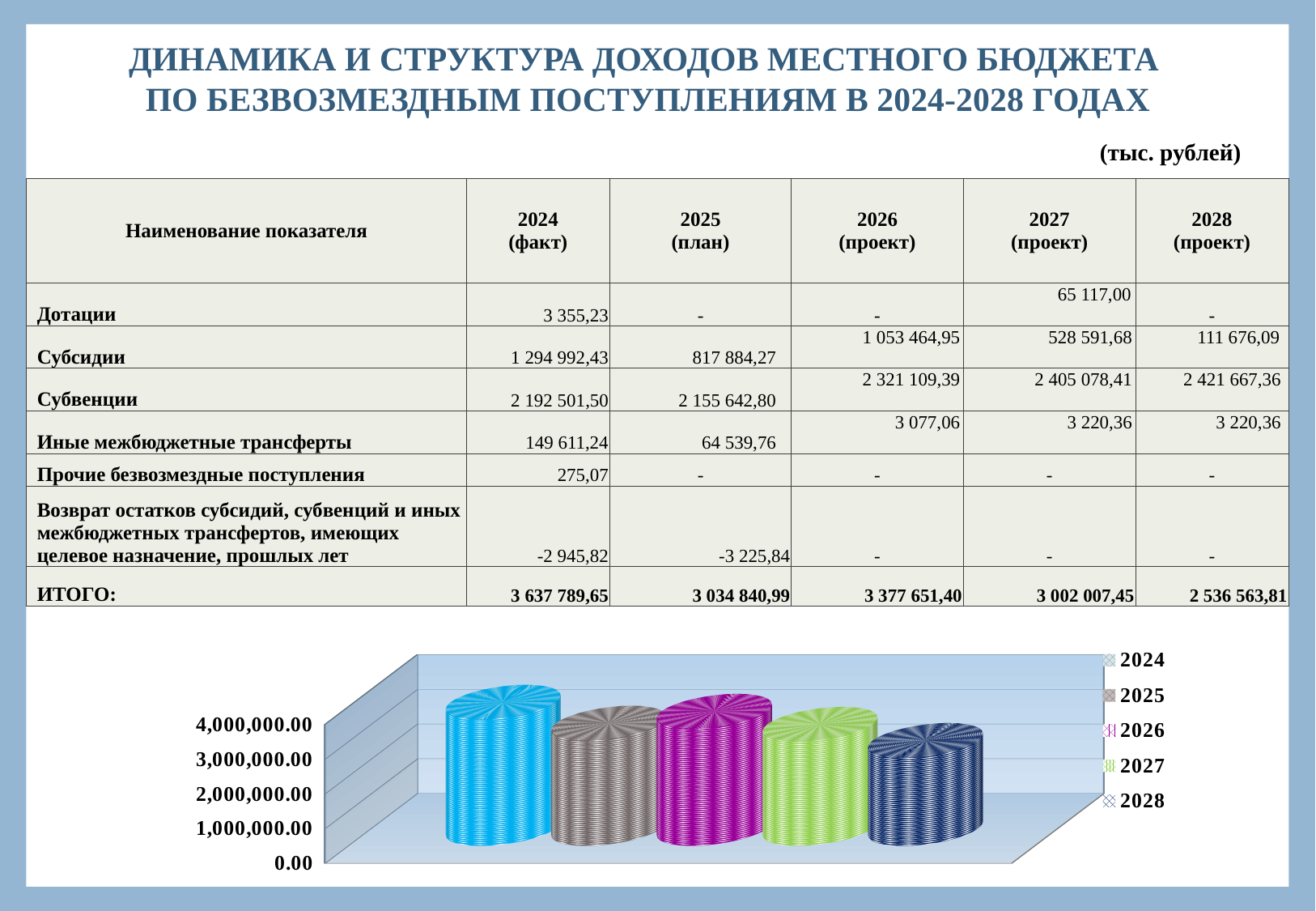
Which bar is taller in the chart, 2026 or 2028? 2026 What is the highest value labelled on the chart's vertical axis? 4,000,000.00 What colour is the bar for 2024 in the chart? light blue According to the ИТОГО row of the table, what is the total for 2024 (факт)? 3 637 789,65 Which year has the tallest bar in the chart? 2024 What kind of chart is shown at the bottom of the slide? bar chart Is the value for 2026 in the chart greater or less than 4,000,000.00? less Which bar is taller in the chart, 2024 or 2028? 2024 Which year has the shortest bar in the chart? 2028 Is the value for 2024 in the chart greater or less than 3,000,000.00? greater How many series does the chart legend list? 5 Is the value for 2028 in the chart greater or less than 3,000,000.00? less